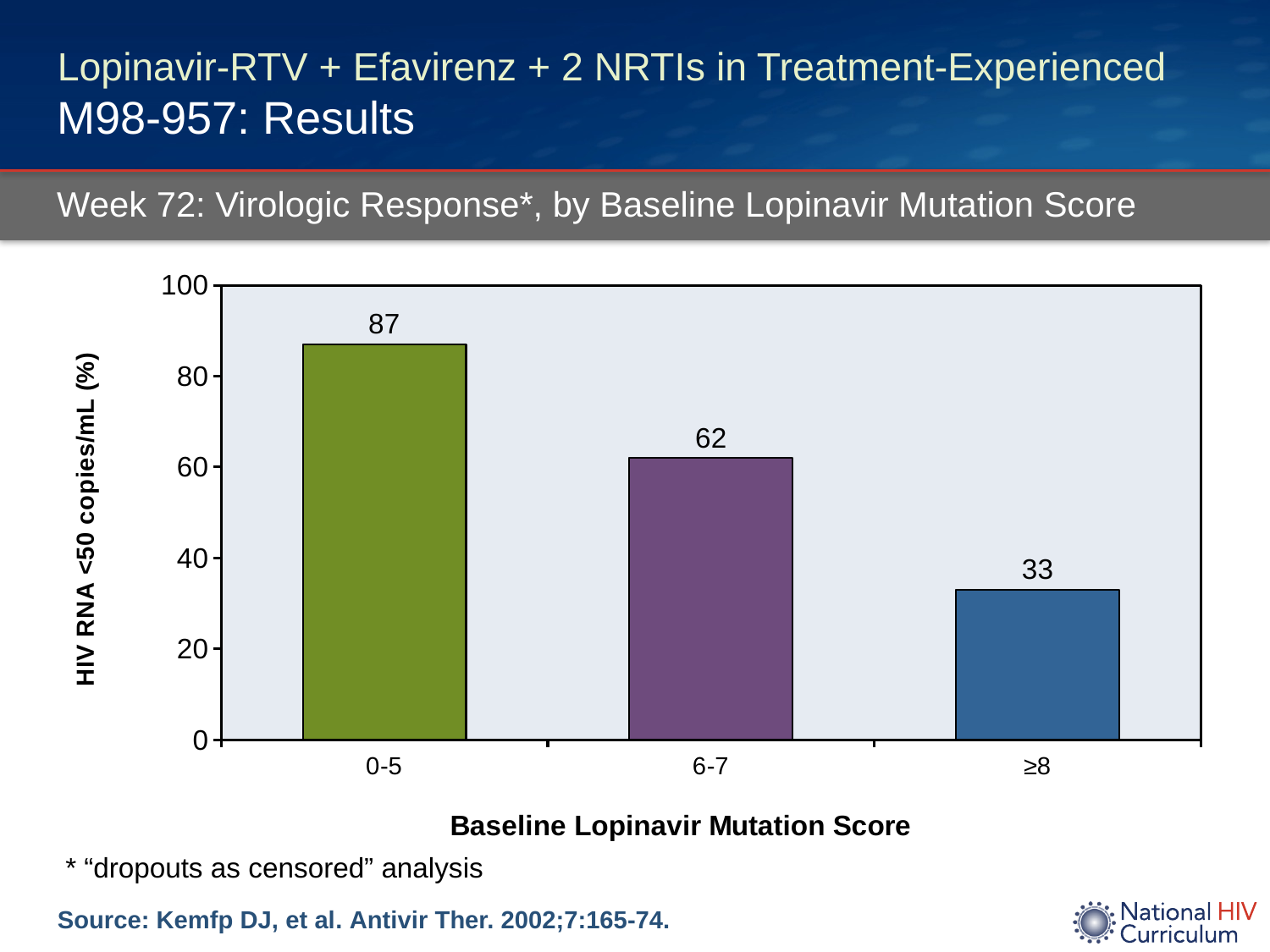
Is the value for the 6-7 category greater or less than 60? greater Which baseline lopinavir mutation score category has the lowest virologic response? ≥8 Which baseline lopinavir mutation score category has the highest virologic response? 0-5 What kind of chart is shown on the slide? Bar chart What is the value for the ≥8 baseline lopinavir mutation score category? 33 How many baseline lopinavir mutation score categories are shown on the chart? 3 What is the difference between the values for the 0-5 and 6-7 categories? 25 What is the value for the 6-7 baseline lopinavir mutation score category? 62 What is the difference between the values for the 0-5 and ≥8 categories? 54 Do the values rise or fall as the baseline lopinavir mutation score increases along the x axis? Fall What is the value for the 0-5 baseline lopinavir mutation score category? 87 Which is larger, the value for 6-7 or the value for ≥8? 6-7